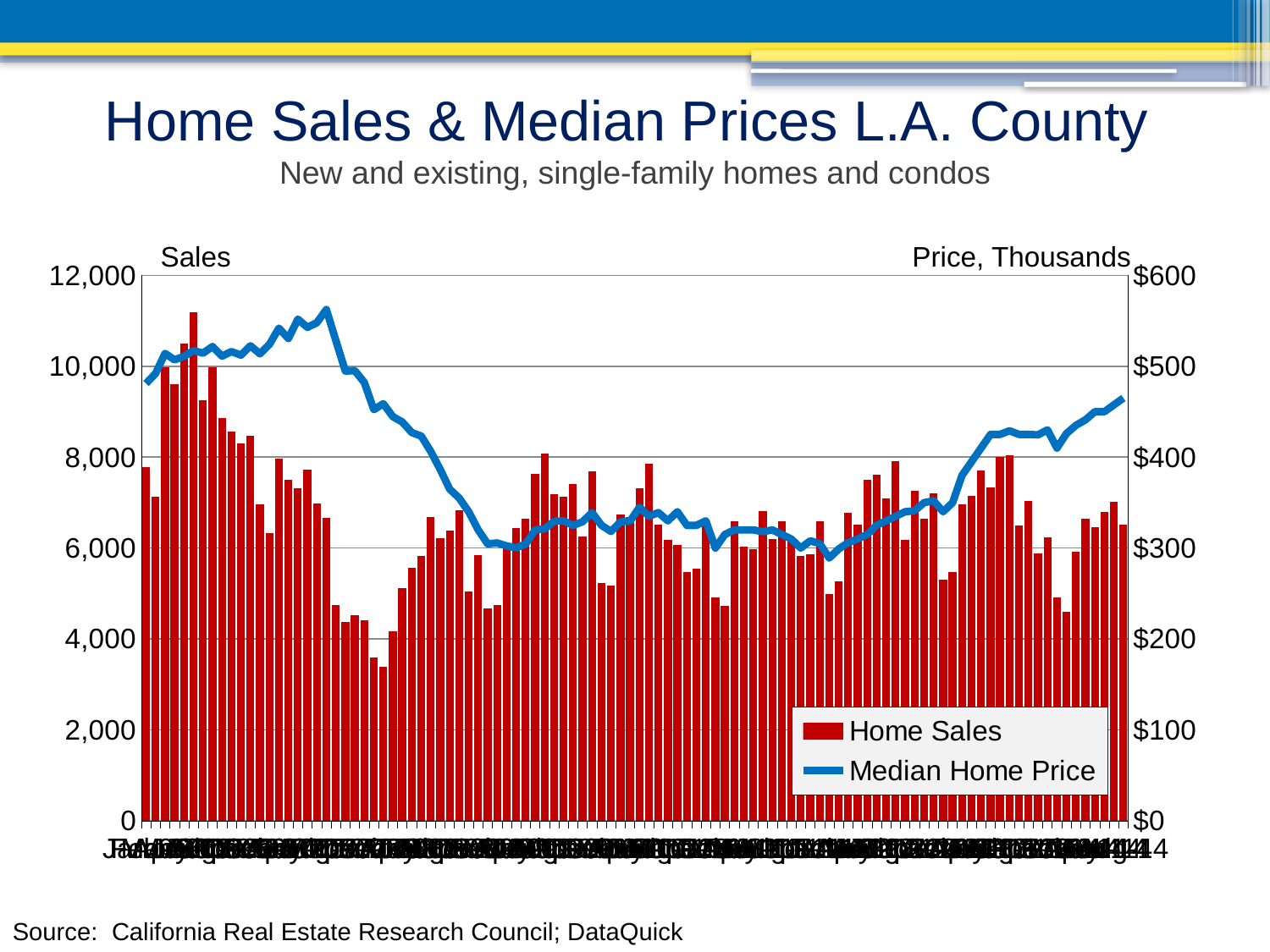
Is the peak of the Median Home Price line greater or less than $500? greater Which series is drawn as red bars and which as a blue line? Home Sales is the red bars; Median Home Price is the blue line Does the Median Home Price line rise or fall immediately after its peak? fall Is the lowest point of the Median Home Price line greater or less than $300? less What kind of chart is shown on the slide? A bar chart combined with a line chart What is the title of the right-hand vertical axis? Price, Thousands Is the lowest Home Sales bar greater or less than 4,000? less Does the Median Home Price line rise or fall over the rightmost portion of the chart? rise How many series does the chart's legend list? 2